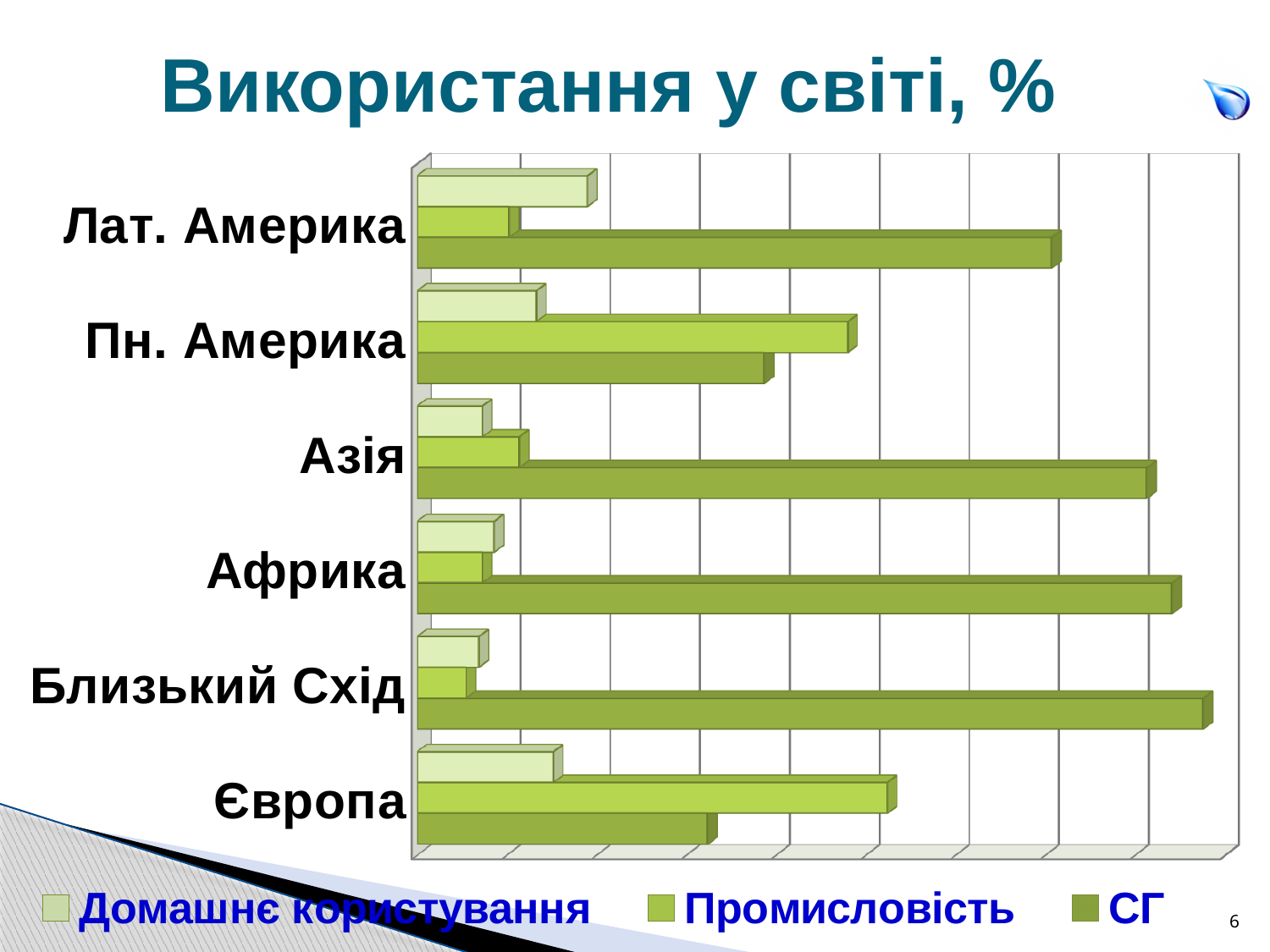
For Європа, which is larger: Промисловість or СГ? Промисловість For Пн. Америка, which is larger: Промисловість or СГ? Промисловість For Азія, which is larger: Промисловість or СГ? СГ Which region has the highest value for Промисловість? Європа Which series does the legend list first? Домашнє користування How many regions (categories) are shown on the chart? 6 What is the title of the chart on the slide? Використання у світі, % Which region has the lowest value for СГ? Європа How many series does the legend list? 3 Which region has the highest value for Домашнє користування? Лат. Америка What kind of chart is shown on the slide? Bar chart